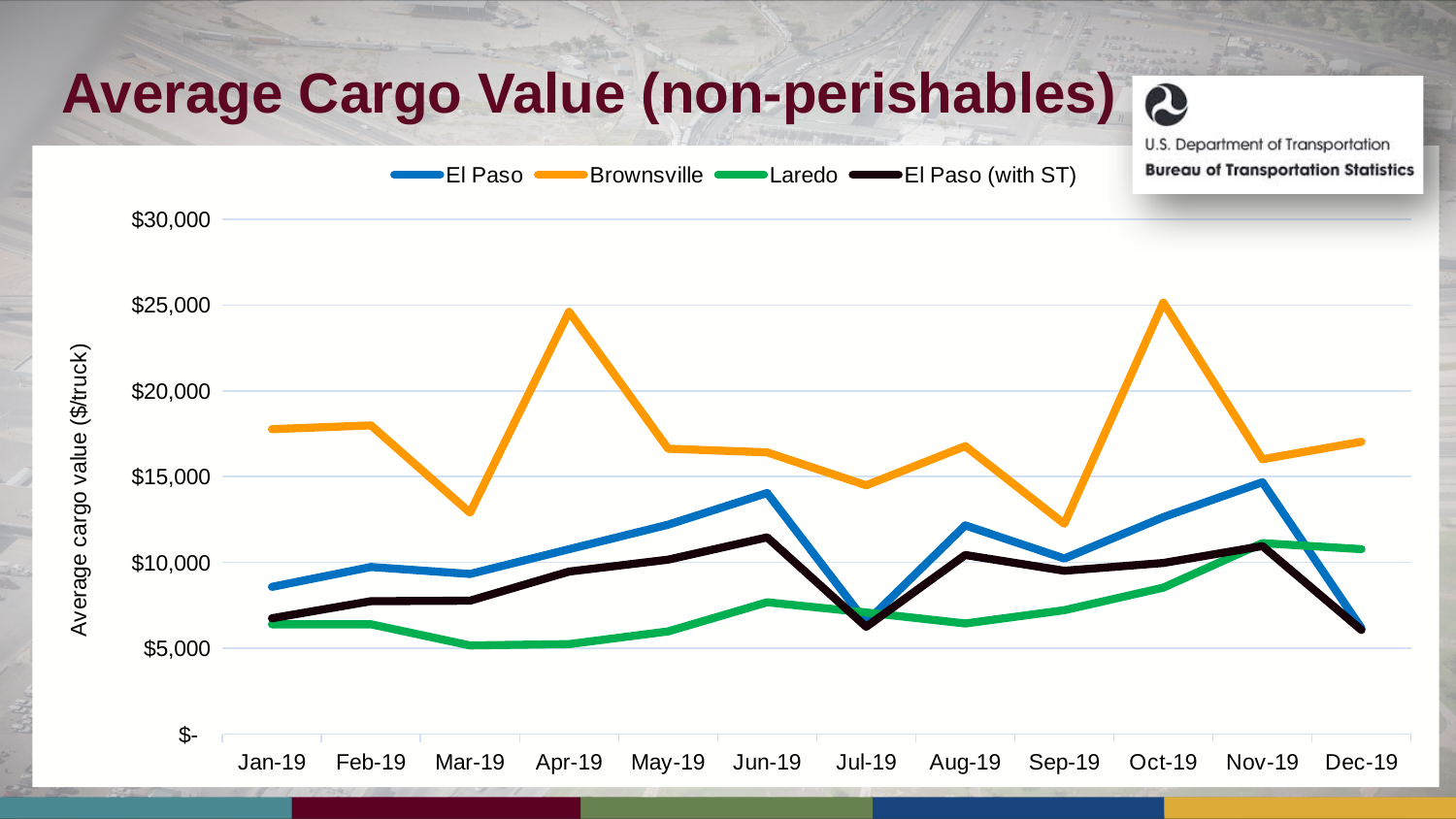
How many months are shown along the x axis? 12 How many series does the legend list? 4 Is the value for Brownsville in Apr-19 greater or less than $20,000? greater What kind of chart is shown on the slide? line chart Is the value for Laredo in Mar-19 greater or less than $10,000? less Is the value for Brownsville in Mar-19 greater or less than $15,000? less Does the Brownsville line rise or fall from Apr-19 to May-19? fall Which series has the lowest value in Apr-19? Laredo What is the label on the y axis of the chart? Average cargo value ($/truck) Which series has the highest value in Apr-19? Brownsville Does the El Paso line rise or fall from Jan-19 to Jun-19? rise In Jun-19, which is larger: the value for El Paso or the value for Laredo? El Paso